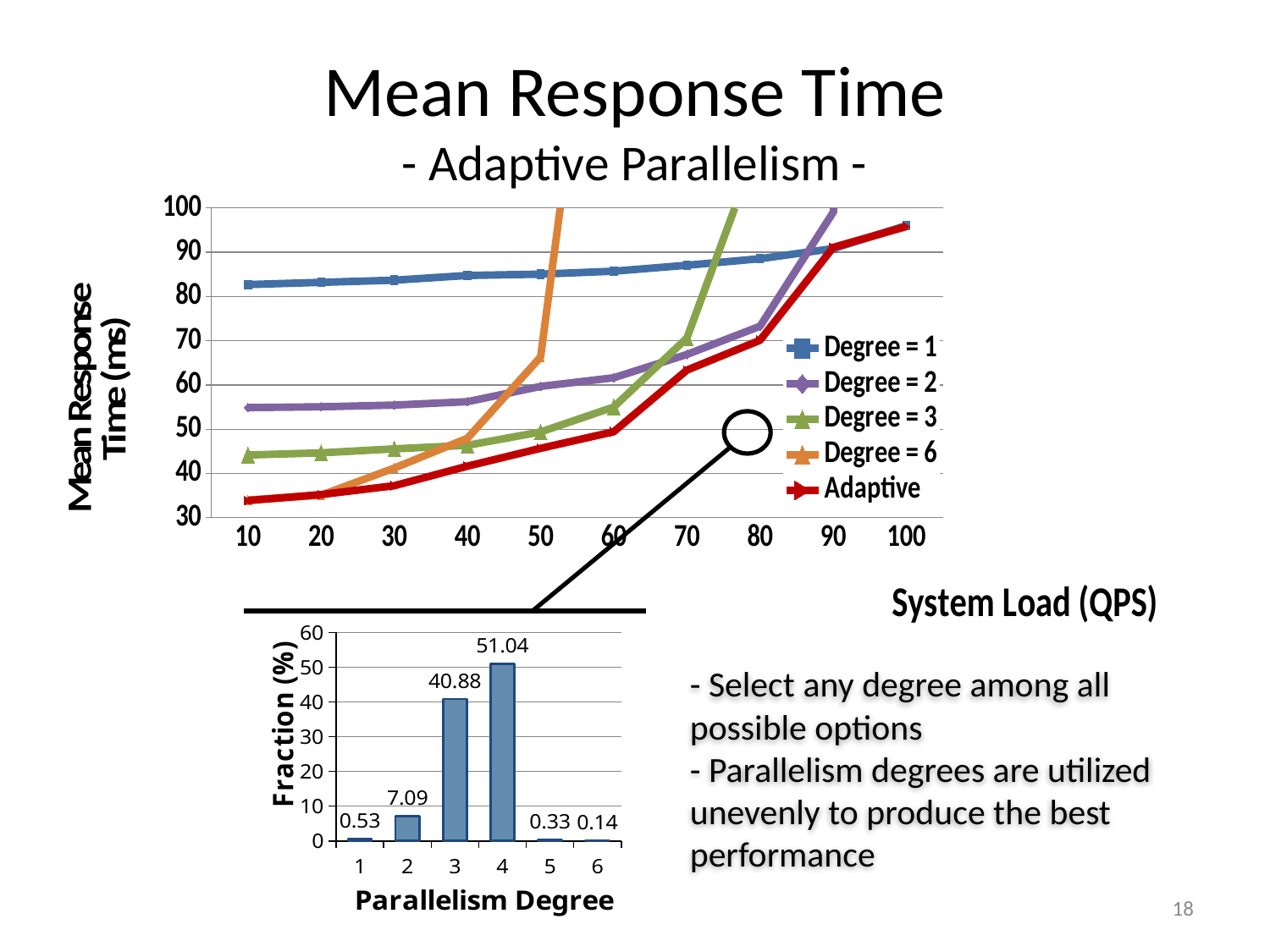
How many series does the legend of the top Mean Response Time chart list? 5 In the bottom bar chart, what is the fraction for parallelism degree 2? 7.09 In the bottom bar chart, which parallelism degree has the highest fraction? 4 How many parallelism degrees are shown in the bottom bar chart? 6 In the top Mean Response Time chart, does the Adaptive series rise or fall as system load increases? Rise In the bottom bar chart, which has a larger fraction: parallelism degree 1 or parallelism degree 2? Parallelism degree 2 In the bottom bar chart, what is the fraction for parallelism degree 4? 51.04 What kind of chart is the top Mean Response Time chart? Line chart In the top Mean Response Time chart, is the value for Degree = 1 at a system load of 10 greater or less than 80? greater In the bottom bar chart, which parallelism degree has the lowest fraction? 6 In the top Mean Response Time chart, is the value for Degree = 3 at a system load of 10 greater or less than 50? less In the bottom bar chart, what is the difference between the fractions for parallelism degree 4 and parallelism degree 3? 10.16